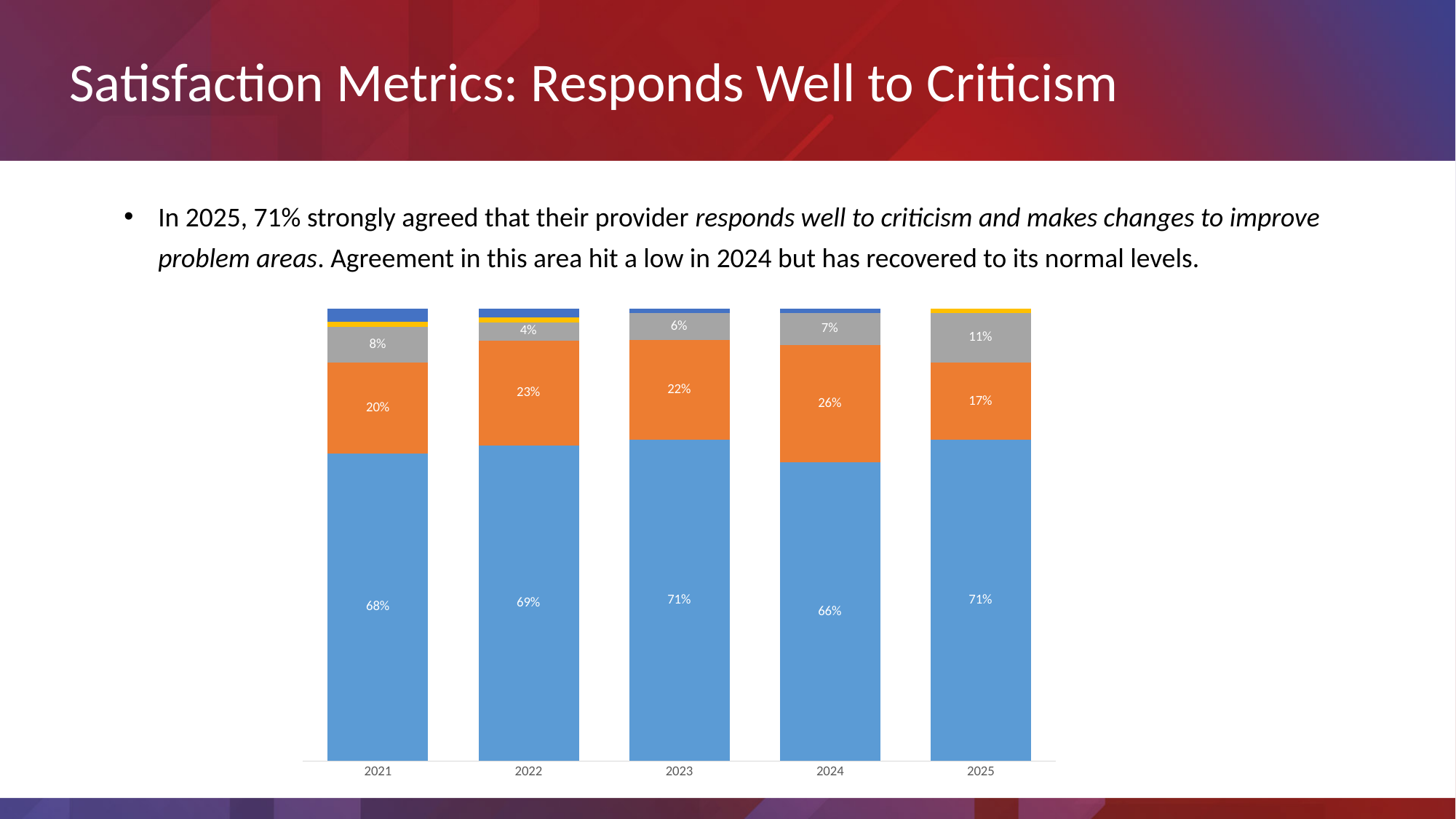
By how many percentage points does the blue (bottom) segment for 2025 exceed that for 2024? 5 Which is larger, the blue (bottom) segment for 2021 or for 2022? 2022 Which year has the highest value for the orange segment? 2024 What is the value of the blue (bottom) segment for 2024? 66% How many years are shown along the x axis of the chart? 5 What is the difference between the orange segment values for 2024 and 2025? 9 percentage points What is the value of the gray segment for 2025? 11% What kind of chart is shown on the slide? Stacked bar chart Which year has the lowest value for the gray segment? 2022 Does the blue (bottom) segment rise or fall from 2021 to 2023? Rise What is the value of the orange segment for 2022? 23% Which year has the lowest value for the blue (bottom) segment? 2024